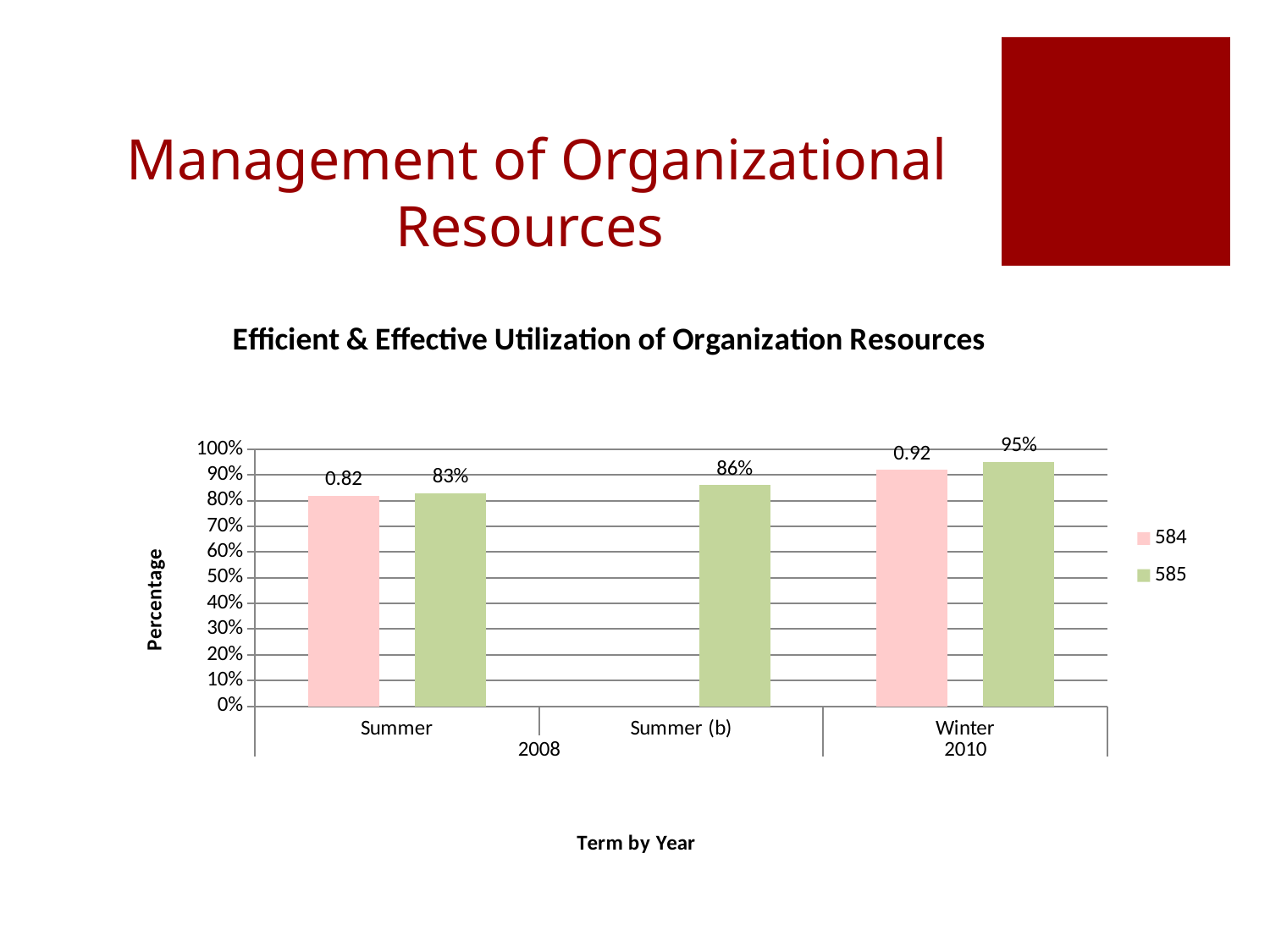
Which term has the lowest value for series 585? Summer How many series does the legend list? 2 What is the difference between the 585 values for Winter and Summer (b)? 9 percentage points Which term has the highest value for series 585? Winter What is the data label on the 584 bar for Winter 2010? 0.92 What is the value of series 585 for Summer 2008? 83% What is the value of series 585 for Summer (b)? 86% Is the value of series 585 for Summer (b) greater or less than 80%? greater What is the data label on the 584 bar for Summer 2008? 0.82 For Winter 2010, which series has the larger value, 584 or 585? 585 How many terms are shown on the x axis? 3 Do the values for series 585 rise or fall from Summer to Winter? rise